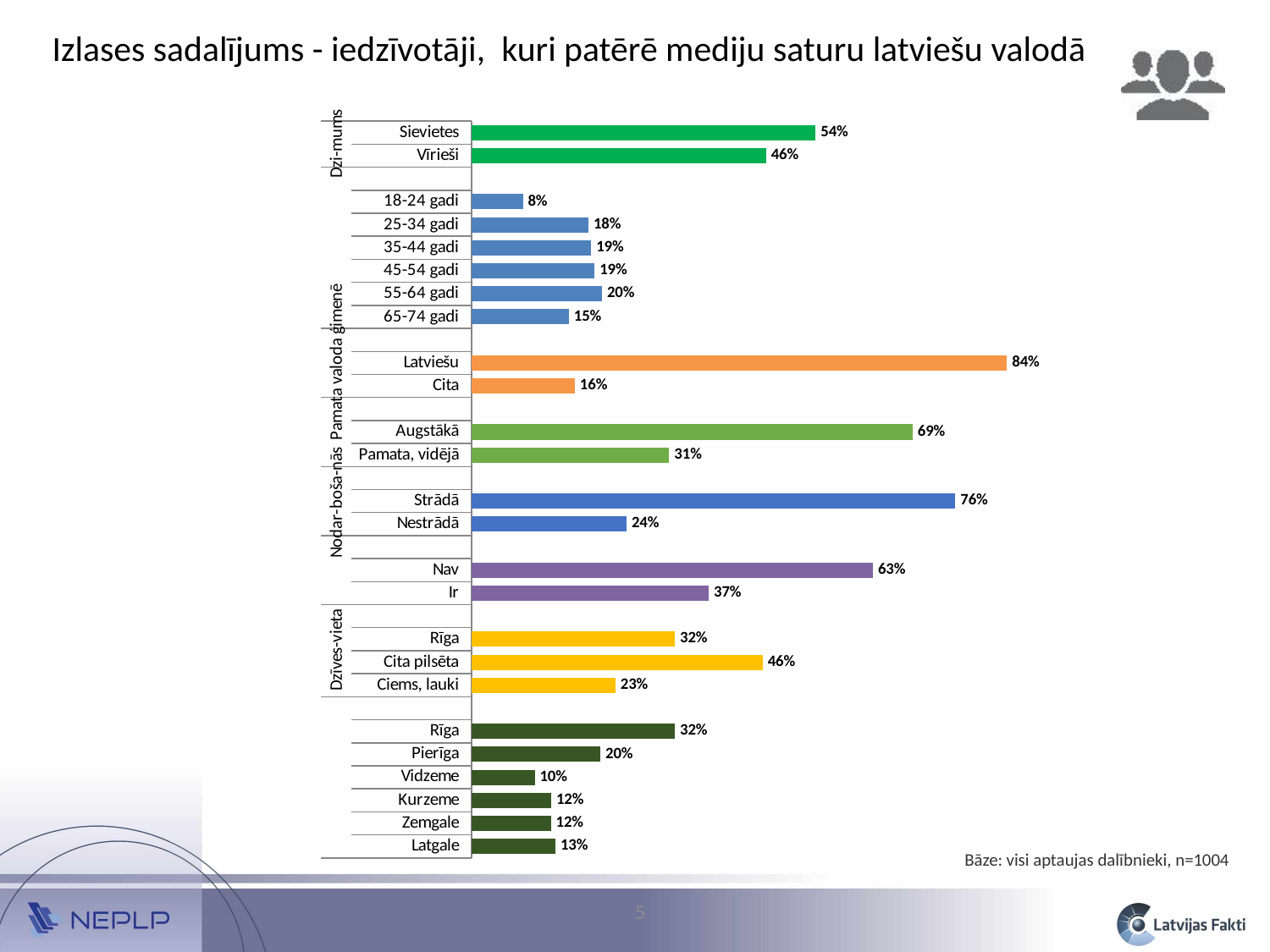
What is the value for Latviešu? 84% Which is larger, Augstākā or Pamata, vidējā? Augstākā What is the value for 18-24 gadi? 8% How many regions are listed in the bottom group (Rīga through Latgale)? 6 What is the value for Vidzeme? 10% Which age group (gadi) has the lowest value? 18-24 gadi What is the value for Cita pilsēta? 46% What is the difference between Strādā and Nestrādā? 52% Which category has the highest value in the whole chart? Latviešu What is the value for Sievietes? 54% What kind of chart is shown on the slide? bar chart What is the difference between Nav and Ir? 26%